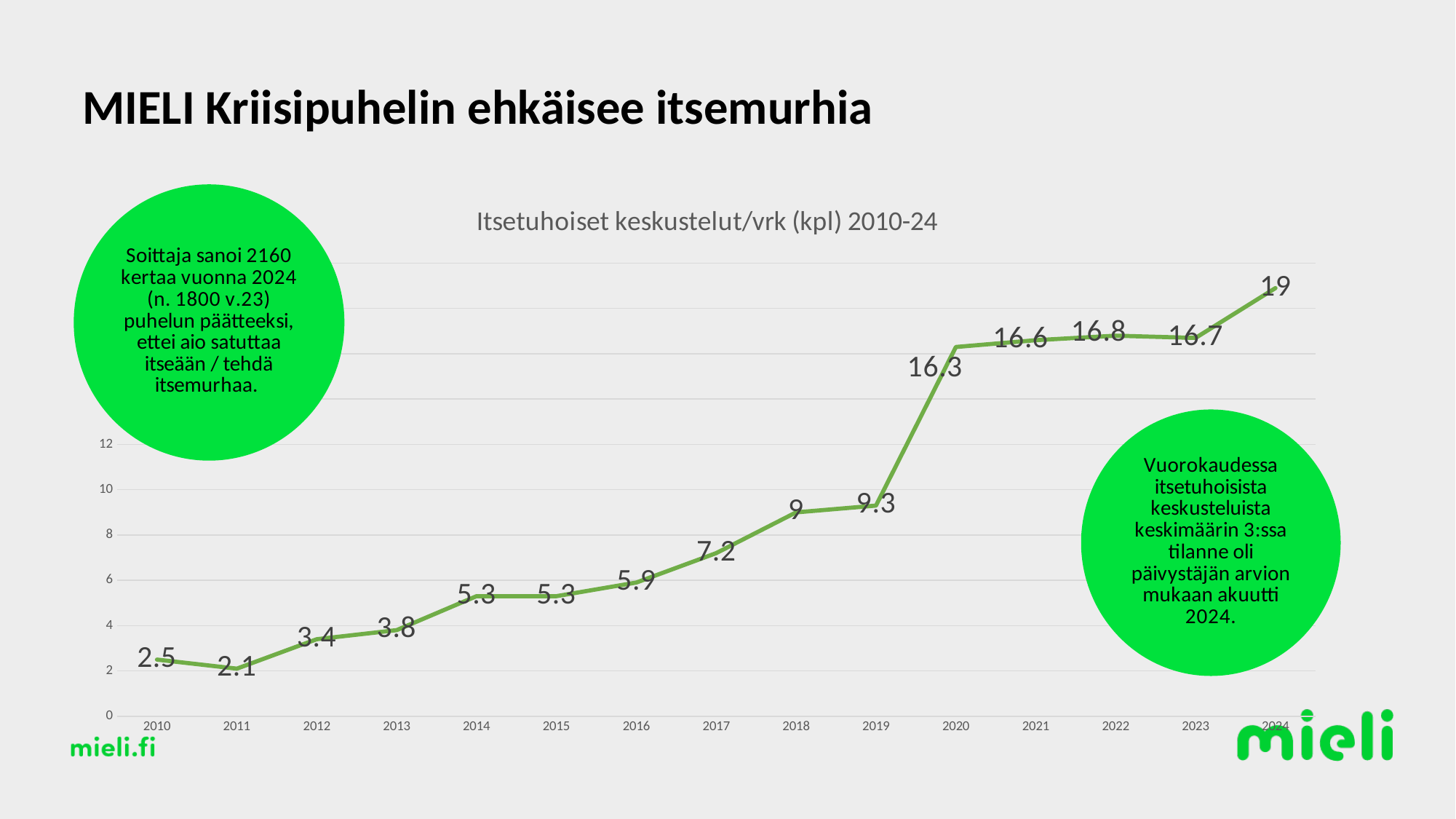
What is the value for 2020? 16.3 How many years are plotted on the chart? 15 What type of chart is shown on the slide? line chart What is the value for 2010? 2.5 What is the difference between the values for 2020 and 2019? 7 What is the title of the chart? Itsetuhoiset keskustelut/vrk (kpl) 2010-24 Do the values generally rise or fall from 2010 to 2024? rise Which year has the highest value? 2024 What is the value for 2017? 7.2 What is the difference between the values for 2024 and 2023? 2.3 Which is larger, the value for 2016 or the value for 2017? 2017 Which year has the lowest value? 2011